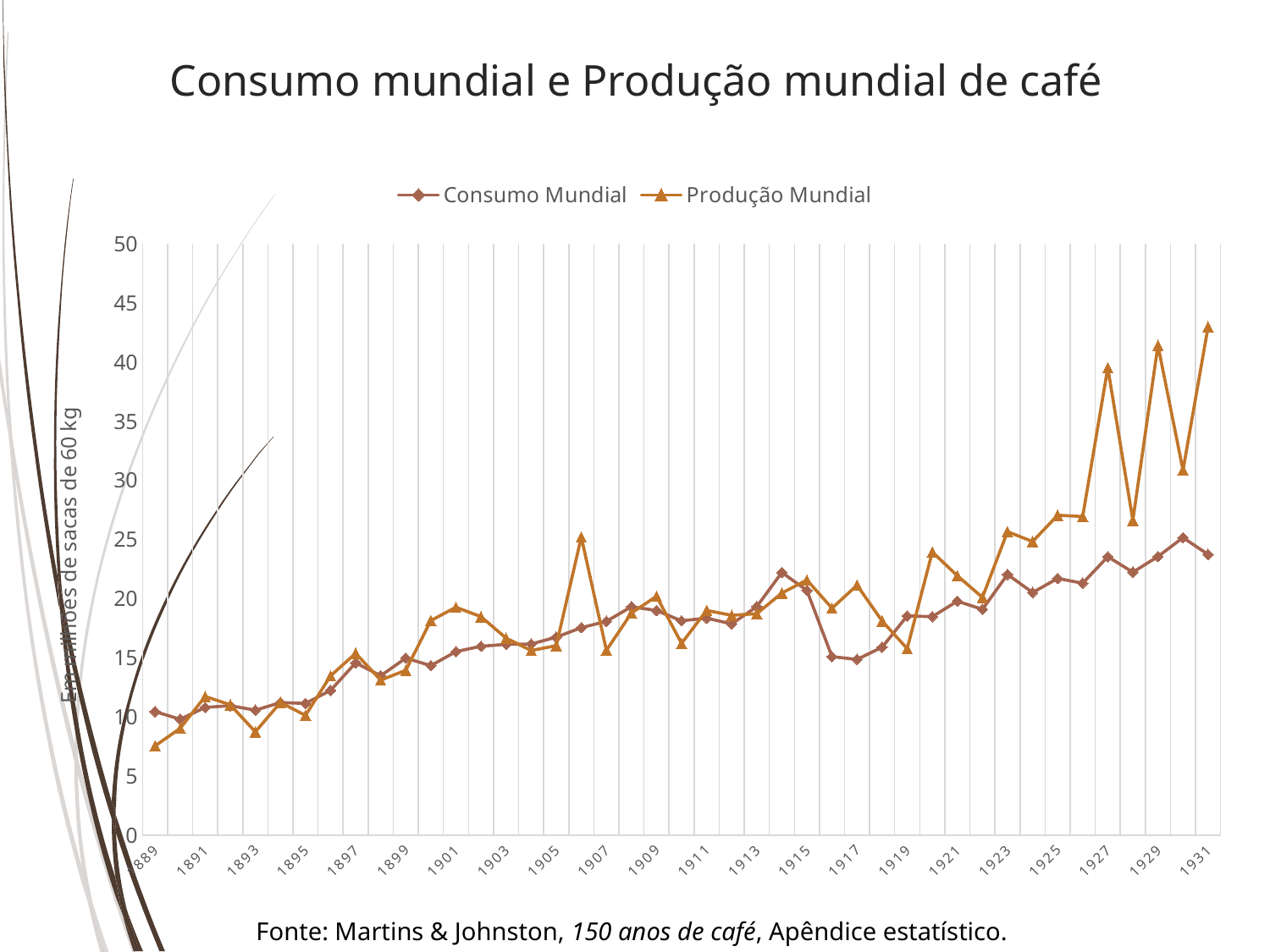
What is the title of the chart? Consumo mundial e Produção mundial de café In which year does Produção Mundial reach its highest value? 1931 Overall, does Consumo Mundial rise or fall from 1889 to 1931? rise In 1916, which is larger: Consumo Mundial or Produção Mundial? Produção Mundial Is the value for Produção Mundial in 1931 greater or less than 40? greater How many series does the legend list? 2 What kind of chart is shown on the slide? line chart Is the value for Produção Mundial in 1889 greater or less than 10? less Is the value for Produção Mundial in 1928 greater or less than 25? greater In which year does Consumo Mundial reach its highest value? 1930 In which year does Produção Mundial have its lowest value? 1889 What are the two series named in the legend? Consumo Mundial and Produção Mundial